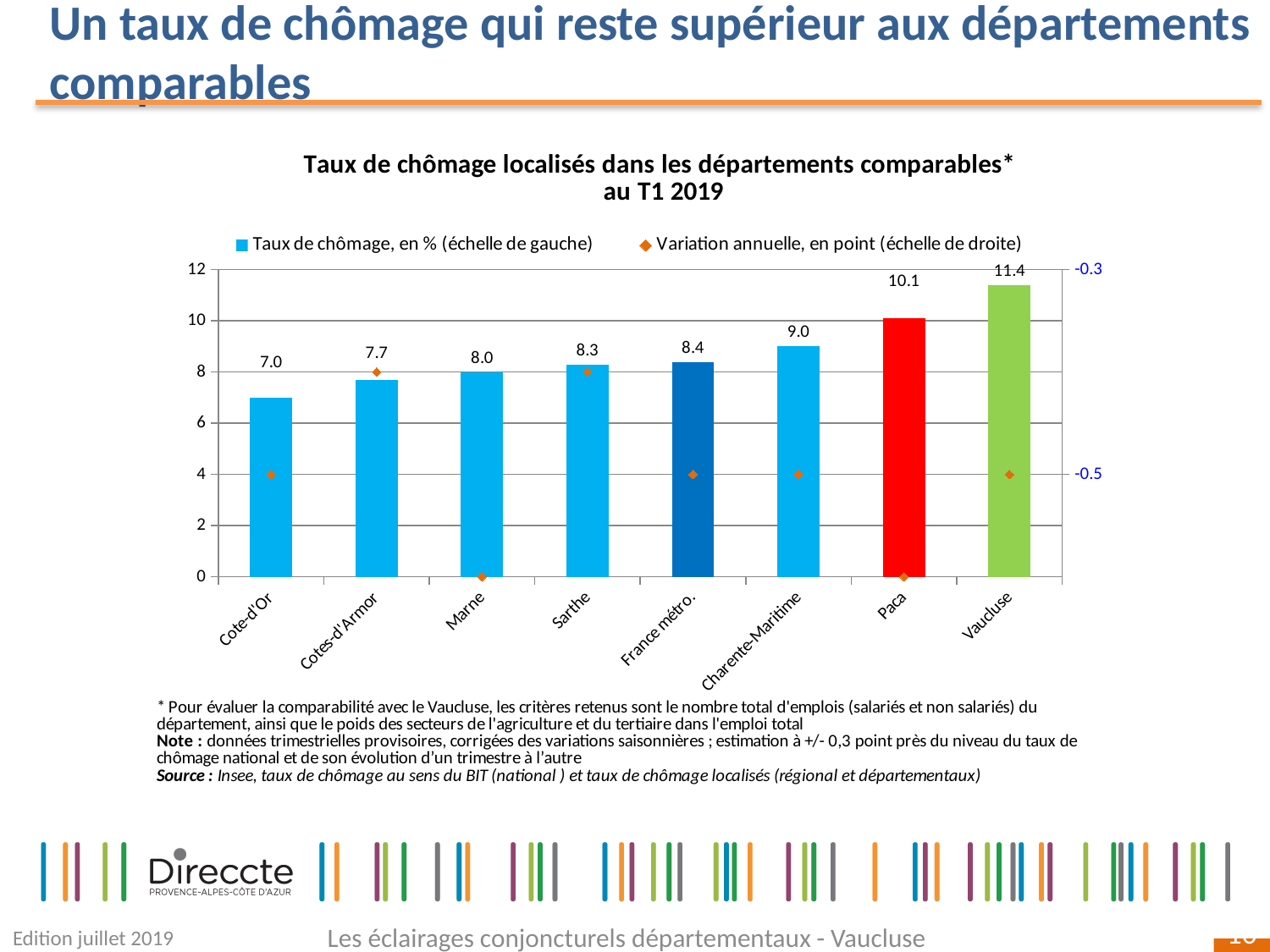
Which department or area has the highest unemployment rate in the chart? Vaucluse What is the unemployment rate shown for Cote-d'Or? 7.0 How many departments or areas are shown on the x axis? 8 What kind of chart is used to show the unemployment rates? Bar chart Which department or area has the lowest unemployment rate in the chart? Cote-d'Or How many series does the legend list? 2 Which has a higher unemployment rate, Charente-Maritime or Sarthe? Charente-Maritime What is the unemployment rate shown for France métro.? 8.4 What is the unemployment rate shown for Paca? 10.1 What is the difference between the unemployment rate of Vaucluse and that of France métro.? 3.0 What is the unemployment rate (taux de chômage) shown for Vaucluse? 11.4 Do the unemployment rate bars rise or fall from left to right along the x axis? Rise